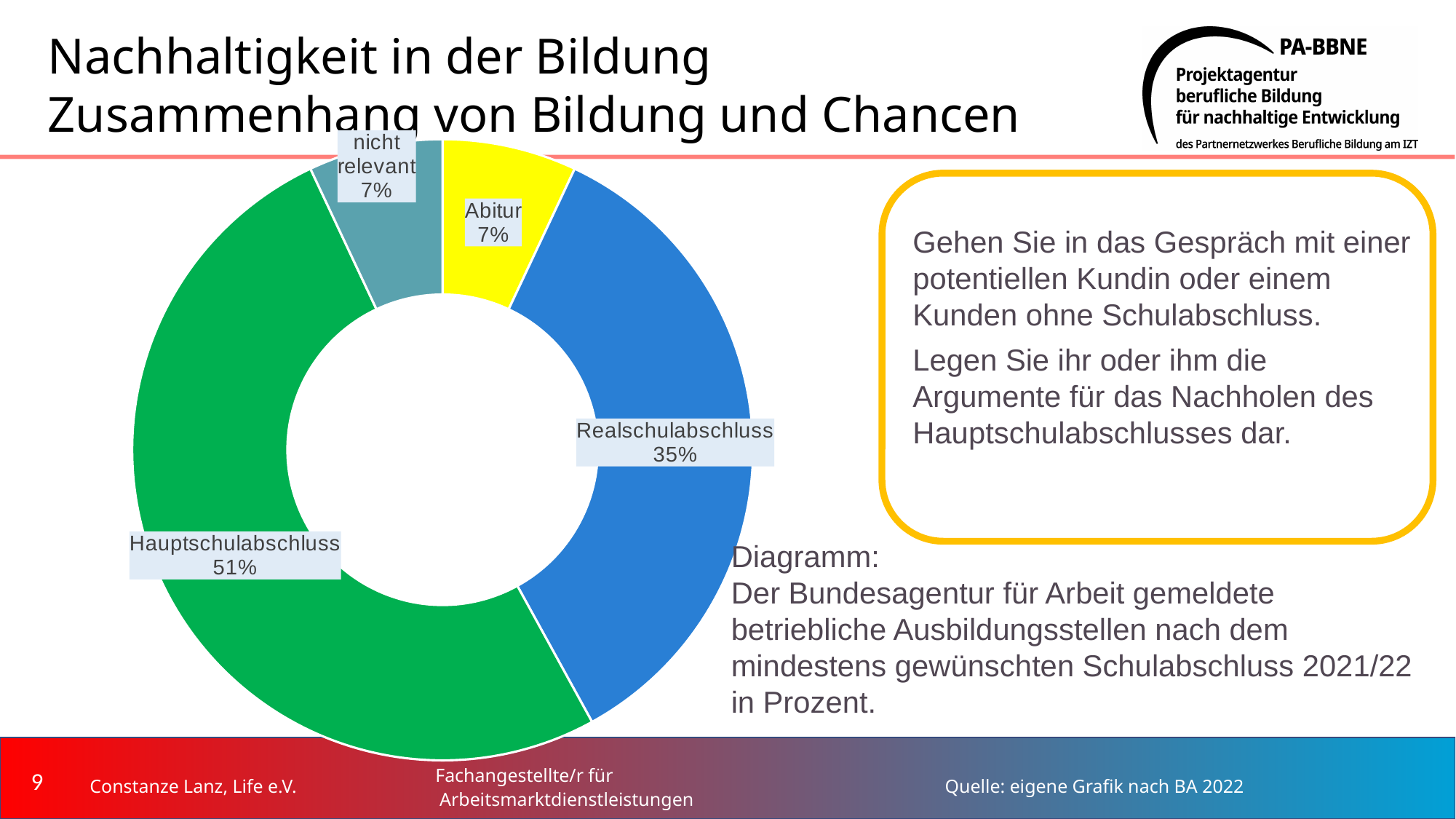
What is the difference in percentage points between Realschulabschluss and 'nicht relevant'? 28 Which is larger, the share for Realschulabschluss or the share for Abitur? Realschulabschluss Which category has the largest share in the chart? Hauptschulabschluss What colour is the Abitur segment of the chart? Yellow What kind of chart is shown on the slide? Pie chart (doughnut) What is the difference in percentage points between Hauptschulabschluss and Realschulabschluss? 16 What share of the chart does Realschulabschluss have? 35% What share of the chart does Hauptschulabschluss have? 51% How many categories are shown in the chart? 4 What share of the chart does 'nicht relevant' have? 7% What colour is the Hauptschulabschluss segment of the chart? Green What share of the chart does Abitur have? 7%